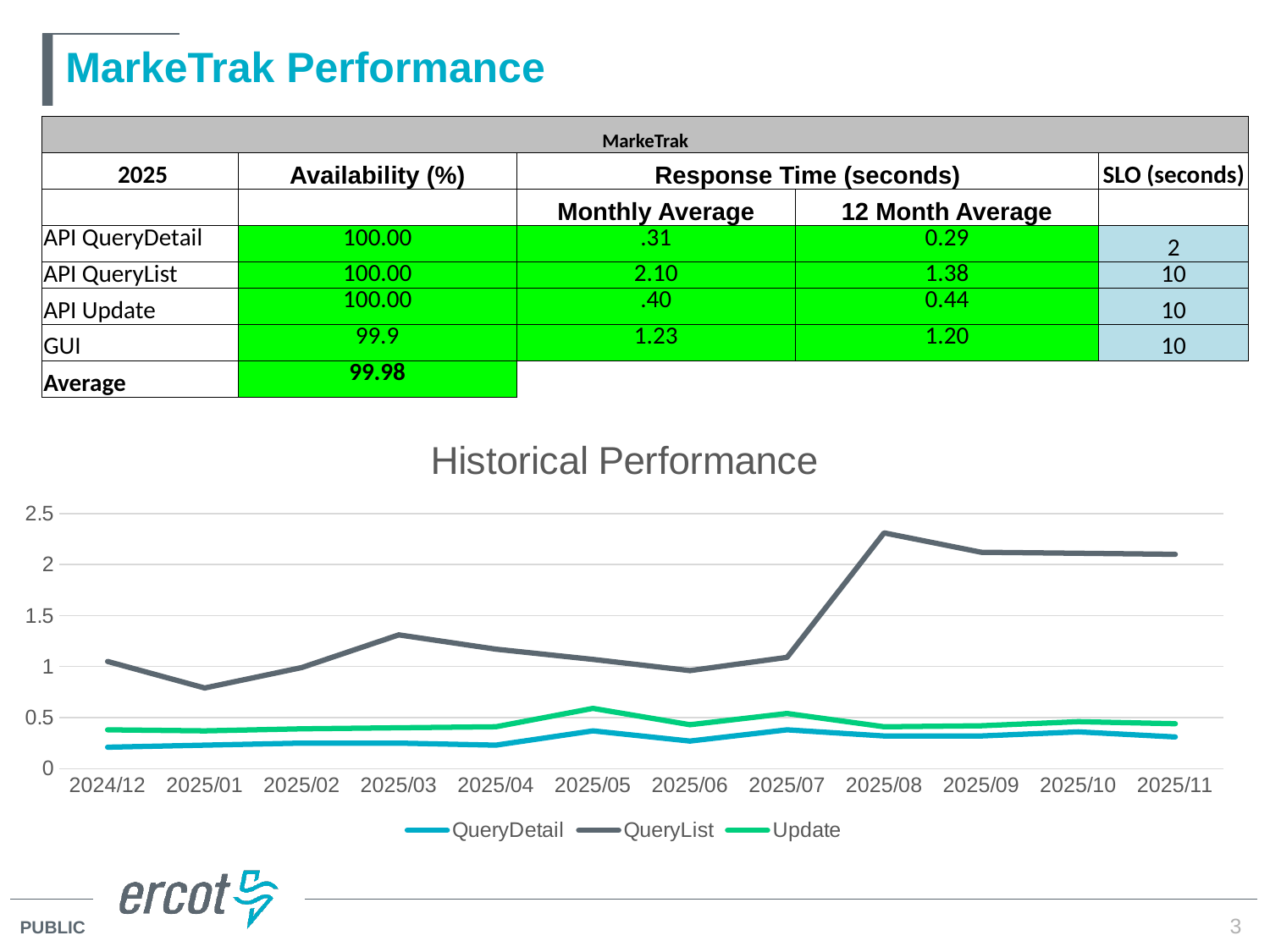
What kind of chart is the Historical Performance chart? line chart In the Historical Performance chart, which is larger at 2025/08: QueryList or QueryDetail? QueryList In the Historical Performance chart, is the QueryDetail value for 2024/12 greater or less than 0.5? less What is the title of the line chart on the slide? Historical Performance In the Historical Performance chart, is the QueryList value for 2025/08 greater or less than 2? greater How many series does the legend of the Historical Performance chart list? 3 In the Historical Performance chart, in which month is the QueryList series at its lowest? 2025/01 How many months are plotted along the x axis of the Historical Performance chart? 12 In the Historical Performance chart, which series has the highest values across the period? QueryList In the Historical Performance chart, is the QueryList value for 2025/01 greater or less than 1? less In the Historical Performance chart, in which month does the QueryList series reach its highest value? 2025/08 In the Historical Performance chart, does the QueryList series rise or fall between 2025/07 and 2025/08? rise